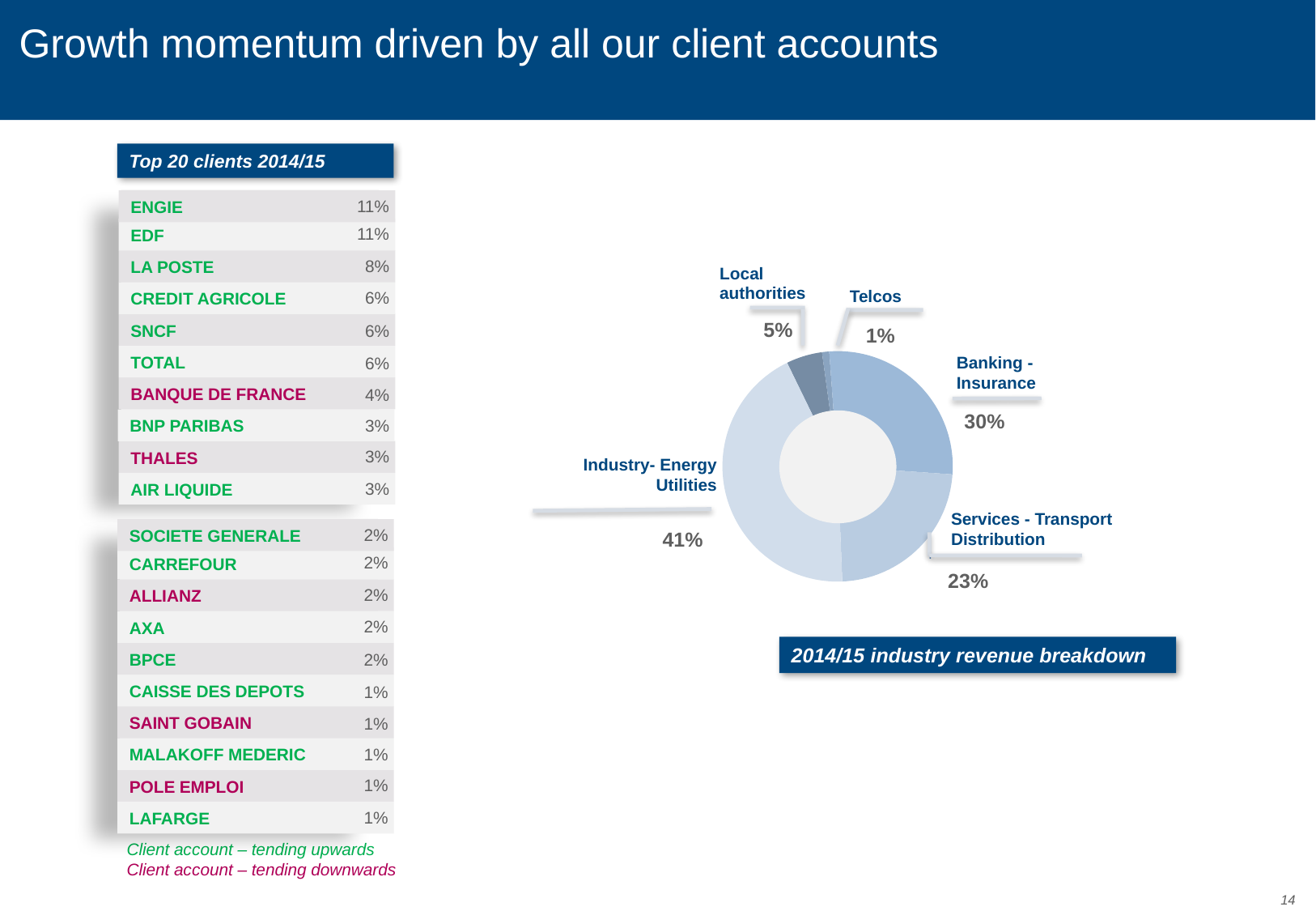
In the 2014/15 industry revenue breakdown chart, what share does Industry - Energy Utilities have? 41% In the 2014/15 industry revenue breakdown chart, what share do Local authorities have? 5% In the 2014/15 industry revenue breakdown chart, what share does Telcos have? 1% In the 2014/15 industry revenue breakdown chart, how many industry segments are shown? 5 In the 2014/15 industry revenue breakdown chart, which is larger: Local authorities or Telcos? Local authorities In the 2014/15 industry revenue breakdown chart, what share does Services - Transport Distribution have? 23% In the 2014/15 industry revenue breakdown chart, which industry has the smallest share? Telcos In the 2014/15 industry revenue breakdown chart, what is the difference between the Banking - Insurance share and the Services - Transport Distribution share? 7 percentage points What is the title of the donut chart on the slide? 2014/15 industry revenue breakdown In the 2014/15 industry revenue breakdown chart, which industry has the largest share? Industry - Energy Utilities In the 2014/15 industry revenue breakdown chart, what share does Banking - Insurance have? 30% What kind of chart is the 2014/15 industry revenue breakdown? Pie chart (donut)